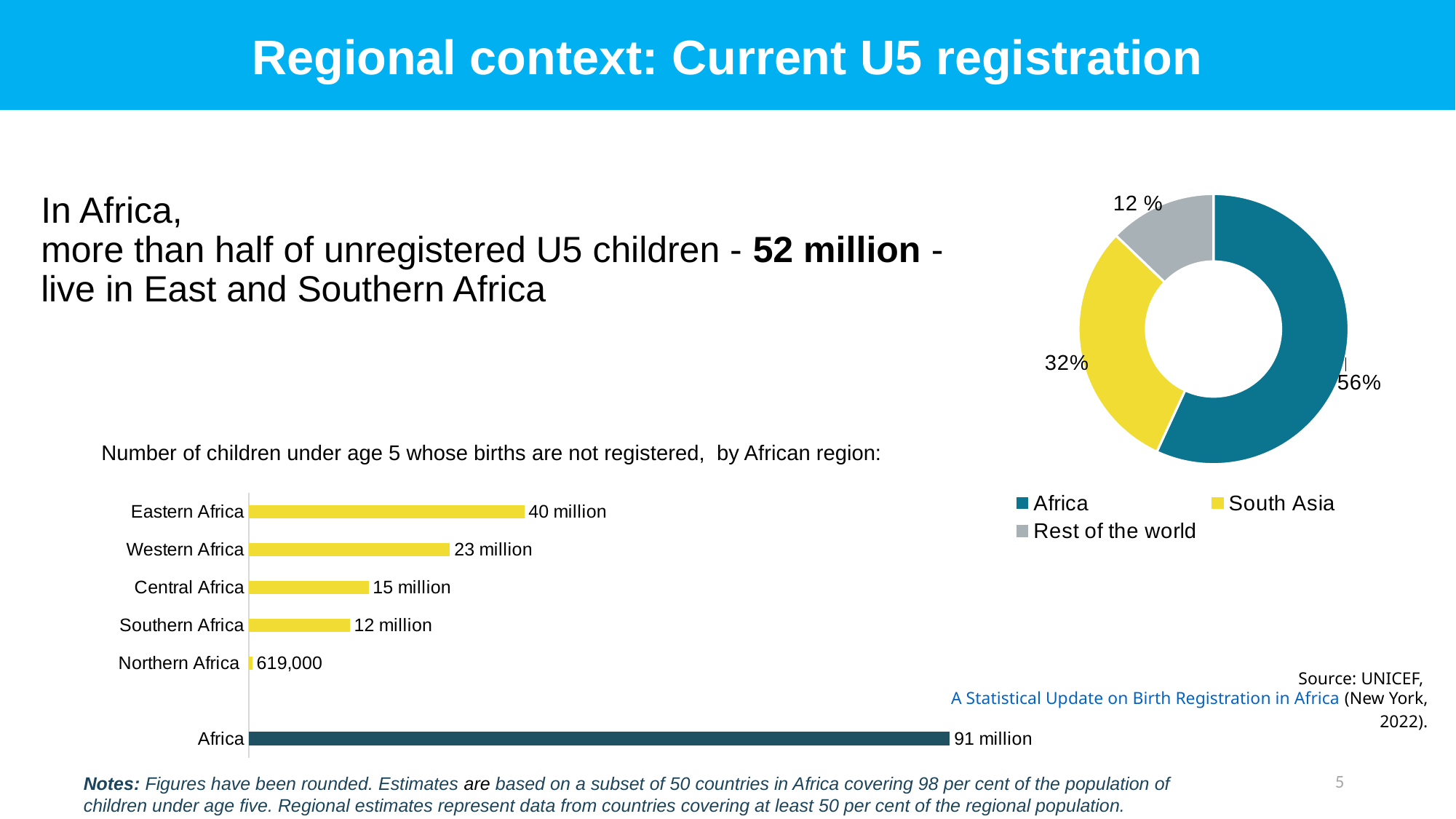
In the bar chart, what is the number of unregistered children under age 5 in Eastern Africa? 40 million In the bar chart, what is the value shown for Africa as a whole? 91 million What type of chart is the chart at the bottom left of the slide? Bar chart In the donut chart, what share is shown for South Asia? 32% In the bar chart, which African sub-region has the highest number of unregistered children under age 5? Eastern Africa In the bar chart, what is the difference between the values for Eastern Africa and Western Africa? 17 million In the bar chart, what is the value shown for Northern Africa? 619,000 In the bar chart, which African sub-region has the lowest number of unregistered children under age 5? Northern Africa In the donut chart, what share is shown for Africa? 56% In the bar chart, which is larger, the value for Central Africa or the value for Southern Africa? Central Africa How many categories (bars) does the bar chart show? 6 How many entries does the legend of the donut chart list? 3